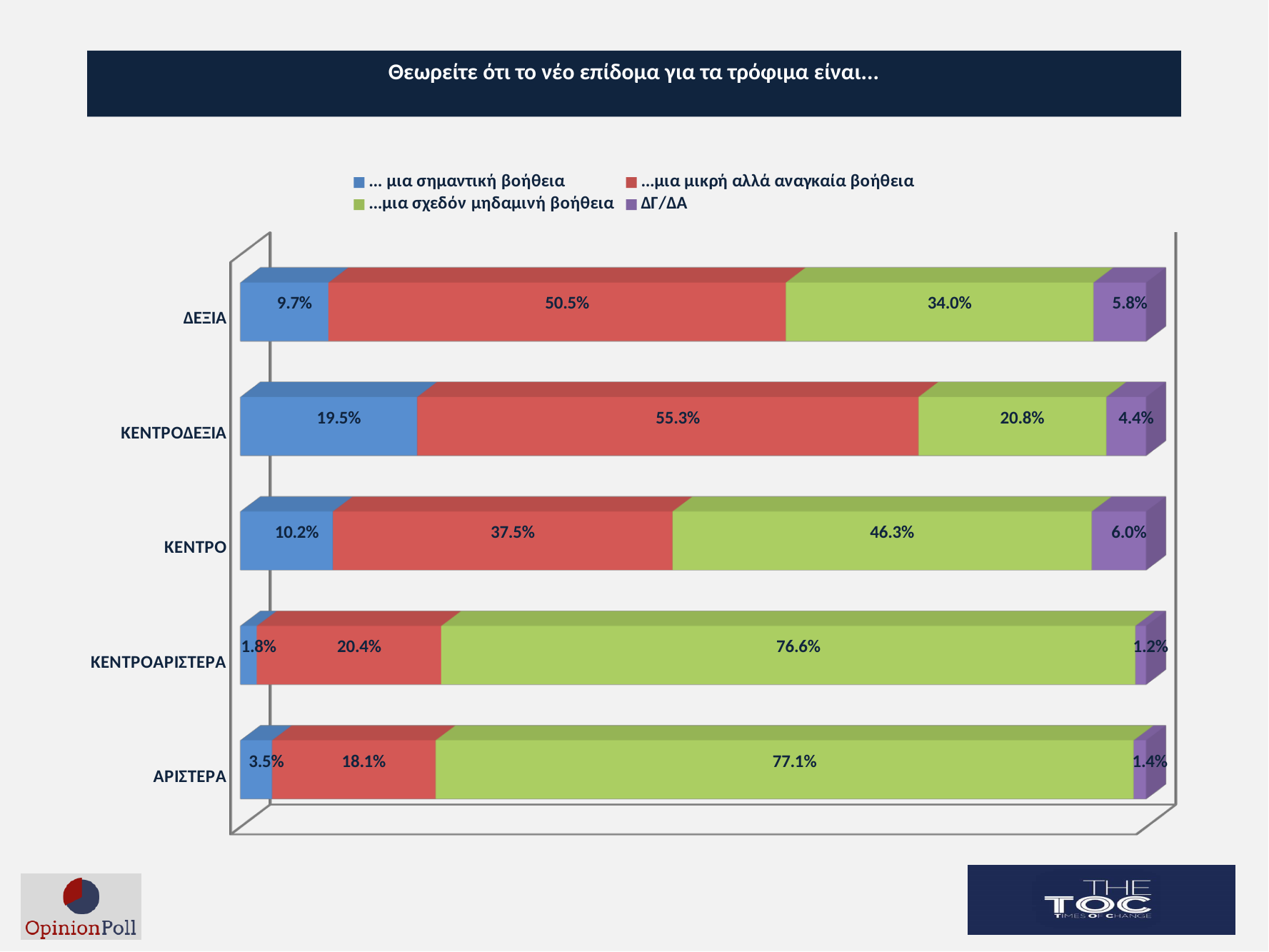
How many series does the legend list? 4 What is the ΔΓ/ΔΑ value for ΚΕΝΤΡΟ? 6.0% What is the value for "...μια σχεδόν μηδαμινή βοήθεια" in the ΑΡΙΣΤΕΡΑ bar? 77.1% What is the difference between the "...μια σχεδόν μηδαμινή βοήθεια" values for ΚΕΝΤΡΟ and ΔΕΞΙΑ? 12.3% Which is larger: the "...μια μικρή αλλά αναγκαία βοήθεια" value for ΔΕΞΙΑ or for ΚΕΝΤΡΟ? ΔΕΞΙΑ Which colour represents "ΔΓ/ΔΑ" in the chart? Purple What kind of chart is shown on the slide? Stacked bar chart What percentage of ΚΕΝΤΡΟΔΕΞΙΑ respondents answered "...μια μικρή αλλά αναγκαία βοήθεια"? 55.3% Which category has the highest value for "... μια σημαντική βοήθεια"? ΚΕΝΤΡΟΔΕΞΙΑ What is the total of the ΚΕΝΤΡΟΑΡΙΣΤΕΡΑ bar? 100.0% Which category has the lowest value for "...μια σχεδόν μηδαμινή βοήθεια"? ΚΕΝΤΡΟΔΕΞΙΑ How many political-position categories are shown on the chart? 5